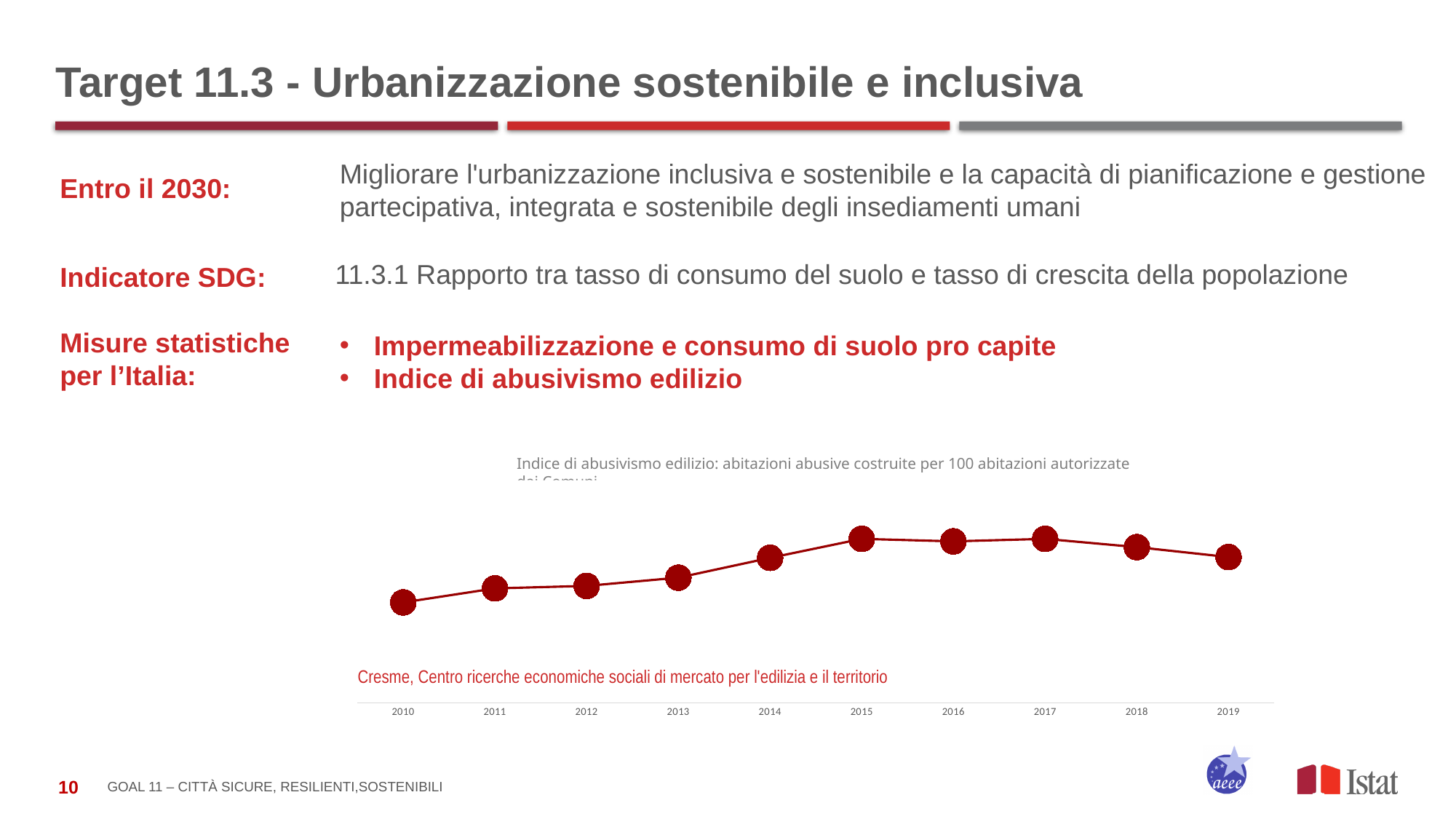
What colour is the line in the chart? dark red Does the value rise or fall from 2017 to 2019? fall Does the value rise or fall from 2010 to 2015? rise Which is larger, the value for 2013 or the value for 2014? 2014 Which is larger, the value for 2010 or the value for 2019? 2019 Which year has the lowest value in the chart? 2010 Which is larger, the value for 2018 or the value for 2019? 2018 How many years are plotted on the x axis of the chart? 10 What is the first year shown on the x axis of the chart? 2010 What is the last year shown on the x axis of the chart? 2019 What kind of chart is shown on the slide? line chart What source is cited below the chart? Cresme, Centro ricerche economiche sociali di mercato per l'edilizia e il territorio